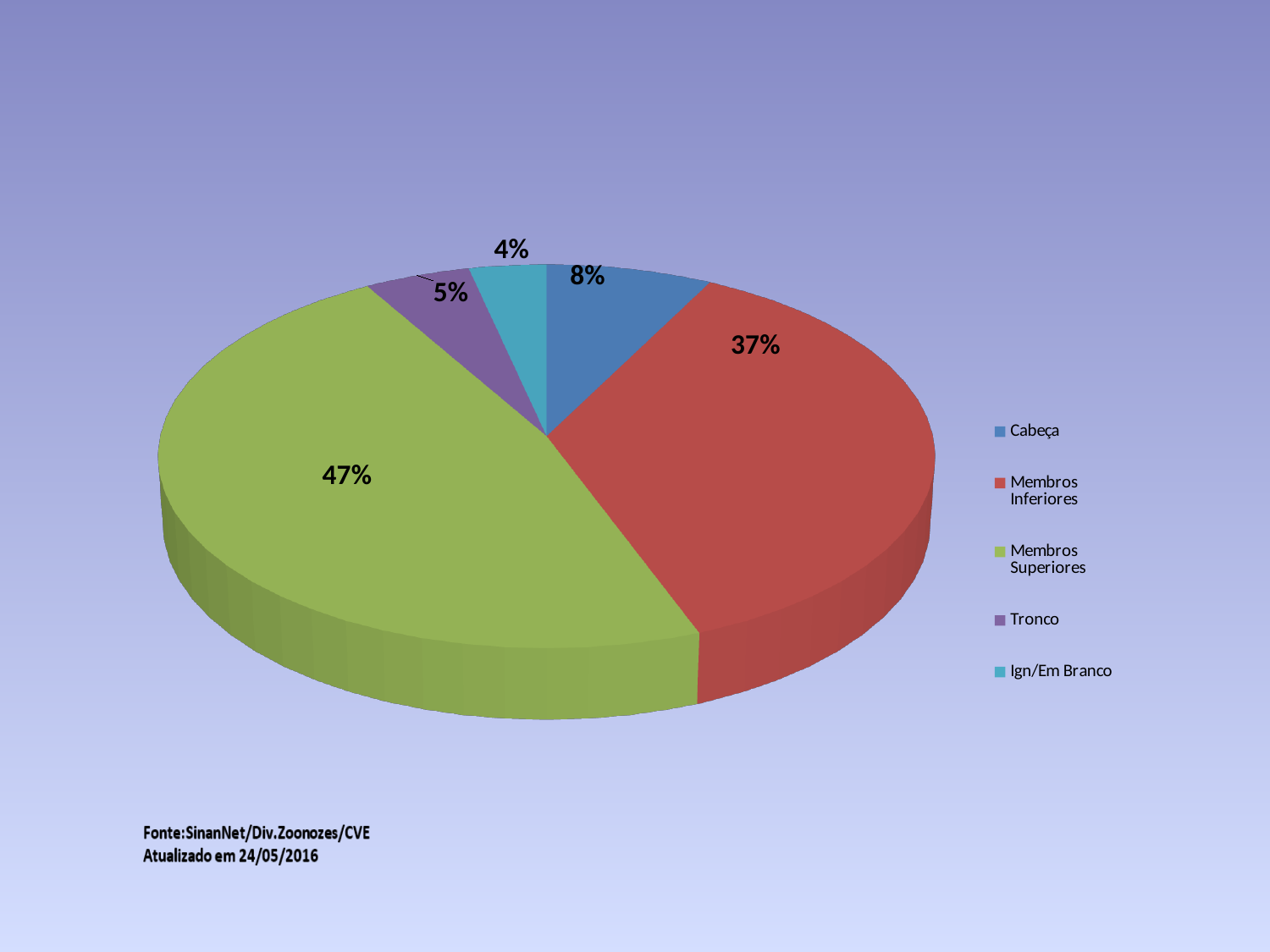
What is the value shown for Tronco? 5% What kind of chart is shown on the slide? Pie chart Which is larger, the share for Cabeça or the share for Tronco? Cabeça What colour is the slice for Membros Inferiores? Red Which category has the smallest slice of the pie? Ign/Em Branco What share of the pie does Membros Inferiores represent? 37% What is the value shown for Ign/Em Branco? 4% What is the difference between the shares of Membros Superiores and Membros Inferiores? 10% Which category has the largest slice of the pie? Membros Superiores How many categories does the pie chart have? 5 What share of the pie does Membros Superiores represent? 47% What is the value shown for Cabeça? 8%